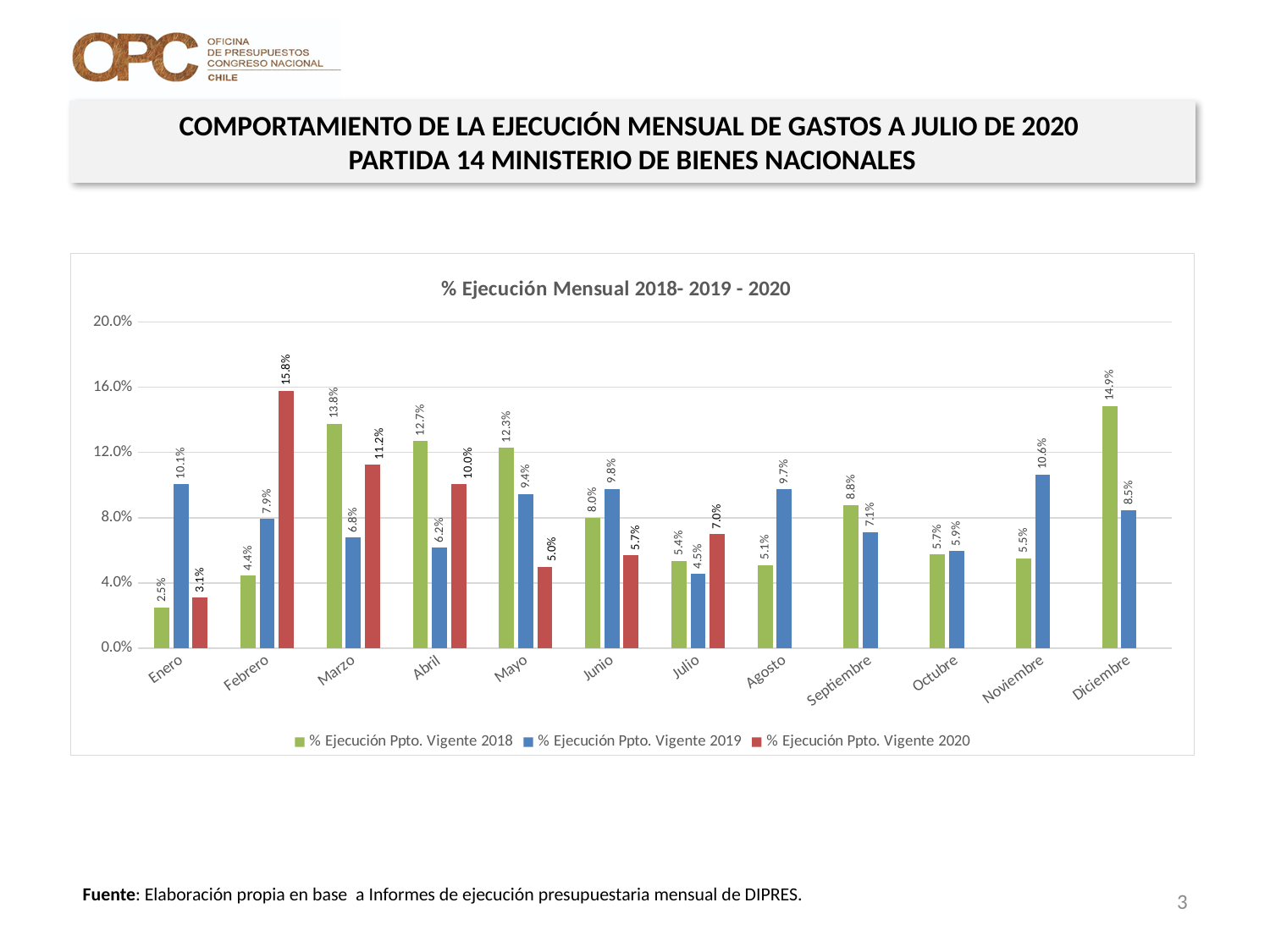
Which month has the highest value for % Ejecución Ppto. Vigente 2020? Febrero Is the value for % Ejecución Ppto. Vigente 2019 in Agosto greater or less than 8.0%? greater How many series does the legend list? 3 Which month has the lowest value for % Ejecución Ppto. Vigente 2018? Enero What is the title of the chart? % Ejecución Mensual 2018- 2019 - 2020 What is the value for % Ejecución Ppto. Vigente 2019 in Noviembre? 10.6% What is the difference between the 2018 and 2019 values in Enero? 7.6% How many months are shown on the x axis? 12 In Marzo, which series is larger: % Ejecución Ppto. Vigente 2018 or % Ejecución Ppto. Vigente 2020? % Ejecución Ppto. Vigente 2018 What kind of chart is shown on the slide? Bar chart What is the value for % Ejecución Ppto. Vigente 2020 in Febrero? 15.8% What is the value for % Ejecución Ppto. Vigente 2018 in Diciembre? 14.9%